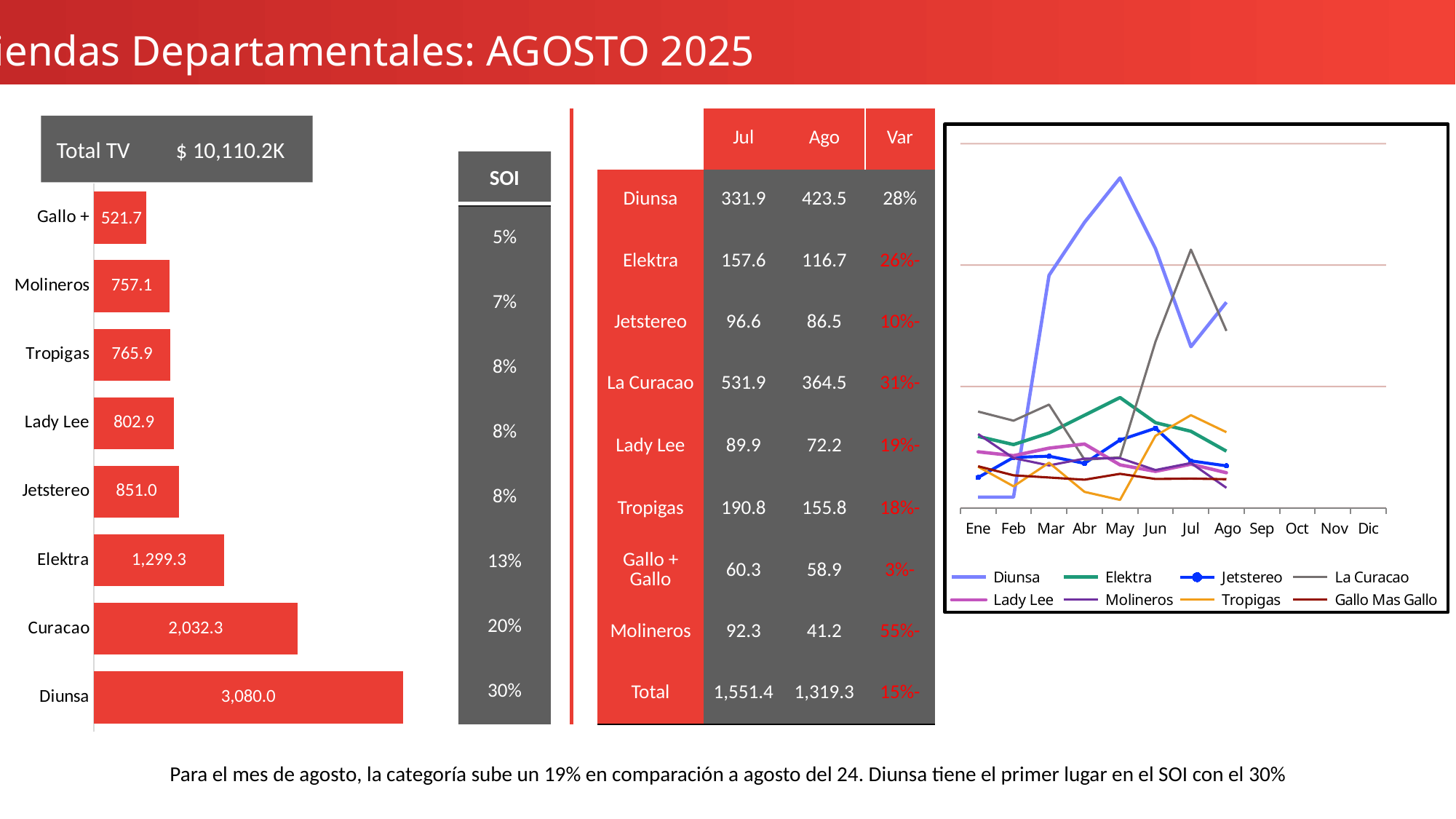
How many categories does the bar chart on the left show? 8 In the bar chart on the left, what is the value for Lady Lee? 802.9 In the bar chart on the left, which is larger, the value for Tropigas or the value for Jetstereo? Jetstereo In the bar chart on the left, which category has the lowest value? Gallo + How many series does the legend of the line chart on the right list? 8 In the bar chart on the left, what is the difference between the values for Elektra and Jetstereo? 448.3 In the bar chart on the left, what is the value for Diunsa? 3,080.0 In the line chart on the right, does the Diunsa line rise or fall from Feb to May? Rise In the bar chart on the left, what is the difference between the values for Diunsa and Curacao? 1,047.7 In the bar chart on the left, what is the value for Molineros? 757.1 What kind of chart is the chart on the right side of the slide? Line chart In the bar chart on the left, which category has the highest value? Diunsa